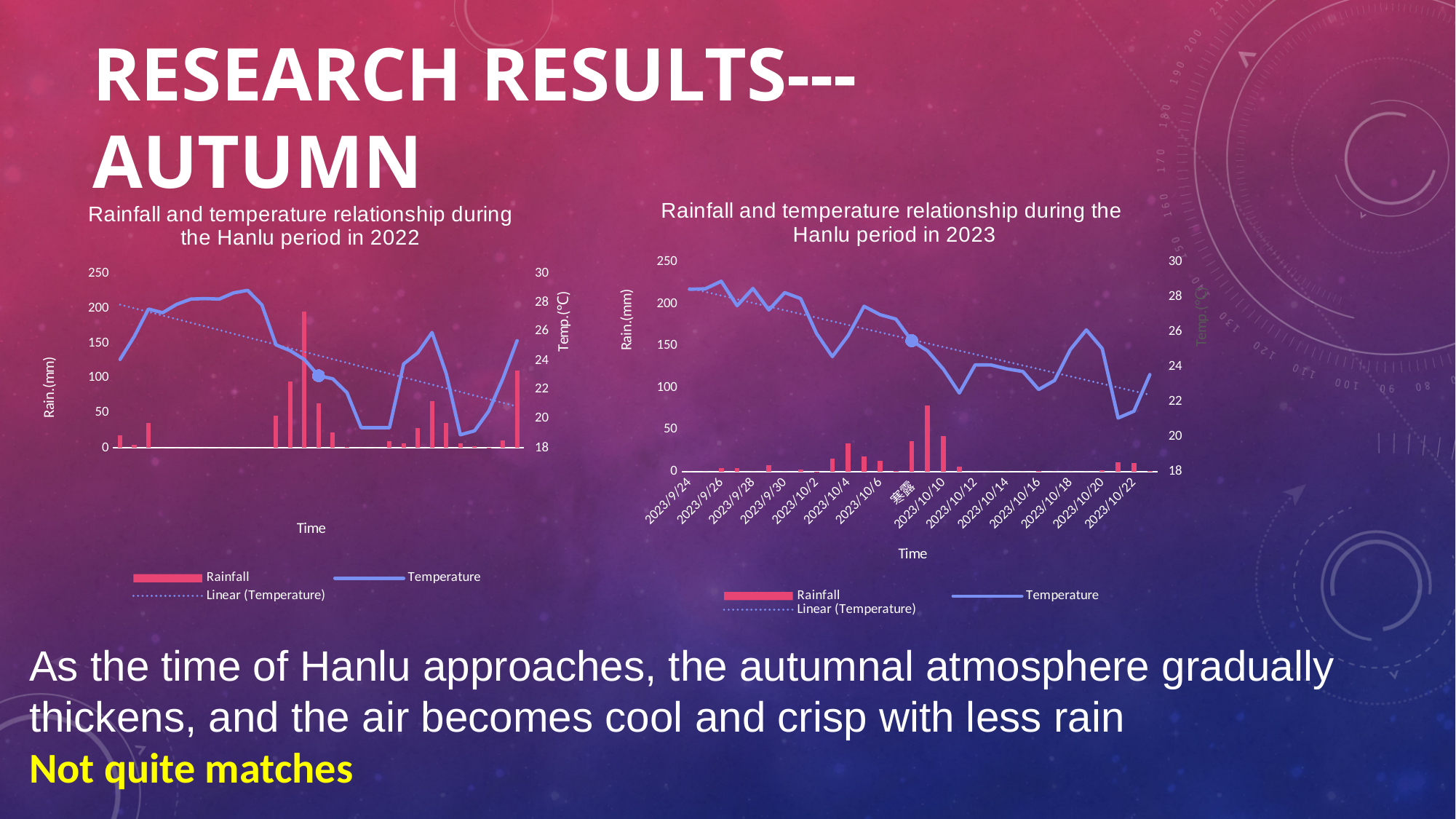
How many series does the legend of the 'Rainfall and temperature relationship during the Hanlu period in 2022' chart list? 3 What is the label of the left vertical axis on the 'Rainfall and temperature relationship during the Hanlu period in 2023' chart? Rain.(mm) In the 'Rainfall and temperature relationship during the Hanlu period in 2023' chart, is the temperature on 2023/9/24 greater or less than 26? greater In the 'Rainfall and temperature relationship during the Hanlu period in 2022' chart, is the highest rainfall bar greater or less than 150? greater In the 'Rainfall and temperature relationship during the Hanlu period in 2023' chart, does the temperature generally rise or fall over time? Fall In the 'Rainfall and temperature relationship during the Hanlu period in 2023' chart, is the temperature on 2023/10/20 greater or less than 22? greater In the 'Rainfall and temperature relationship during the Hanlu period in 2023' chart, which has the higher temperature, 2023/9/24 or 2023/10/22? 2023/9/24 In the 'Rainfall and temperature relationship during the Hanlu period in 2022' chart, does the dotted linear temperature trend line rise or fall along the x axis? Fall In the 'Rainfall and temperature relationship during the Hanlu period in 2023' chart, which series is drawn as bars? Rainfall How many date labels are shown on the x axis of the 'Rainfall and temperature relationship during the Hanlu period in 2023' chart? 15 What kind of chart is the 'Rainfall and temperature relationship during the Hanlu period in 2023' chart? A combined bar and line chart